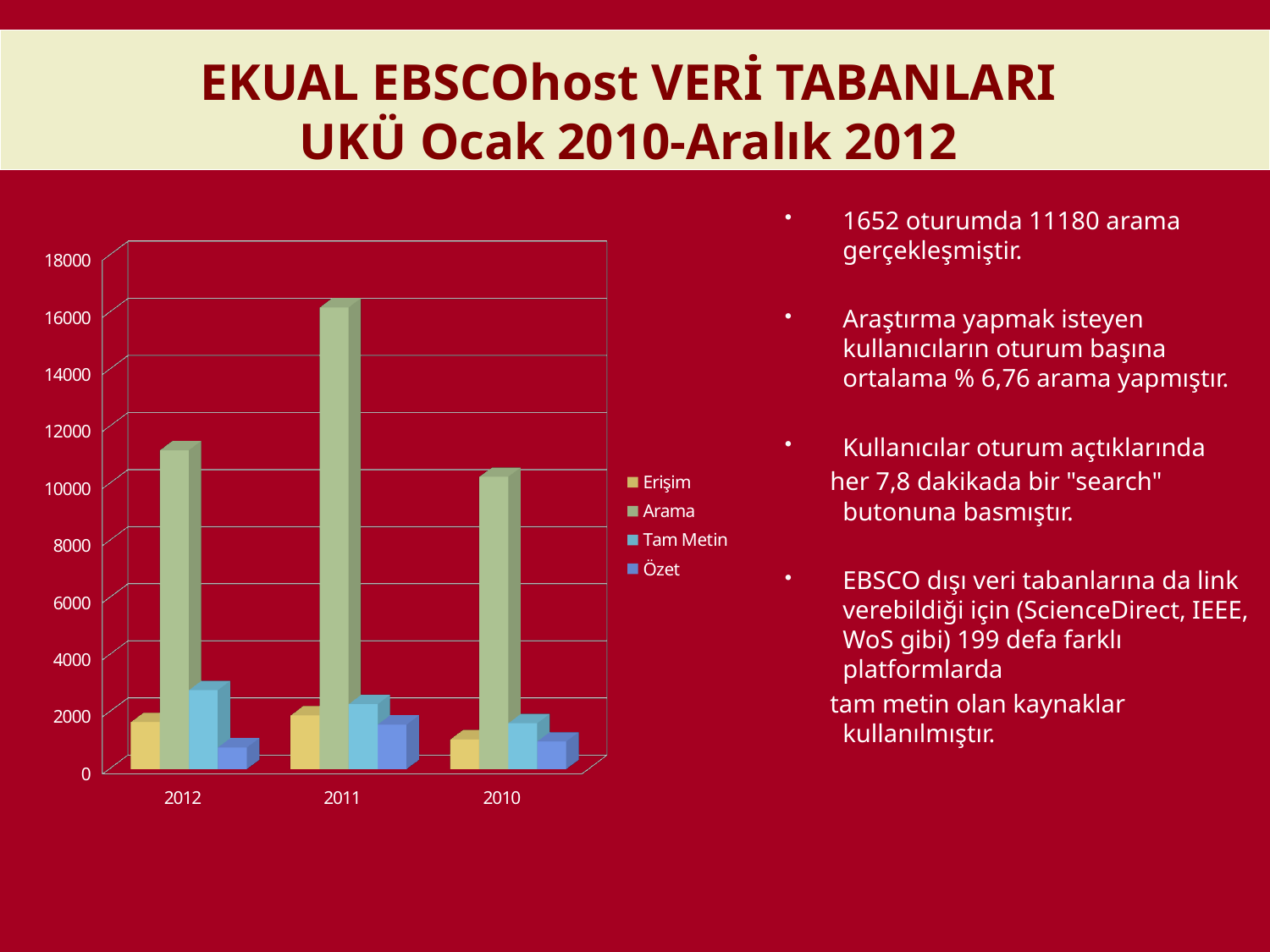
Which series has the tallest bar in every year? Arama Is the Arama value for 2010 greater or less than 12000? less How many years are shown on the x axis of the chart? 3 What kind of chart is shown on the slide? bar chart Is the Arama value for 2012 greater or less than 12000? less In which year is the Arama value highest? 2011 Is the Tam Metin value for 2012 greater or less than 4000? less Which is larger in 2012, the Tam Metin value or the Özet value? Tam Metin How many series does the chart legend list? 4 Which series does the legend list first? Erişim Which is larger, the Arama value for 2011 or the Arama value for 2012? 2011